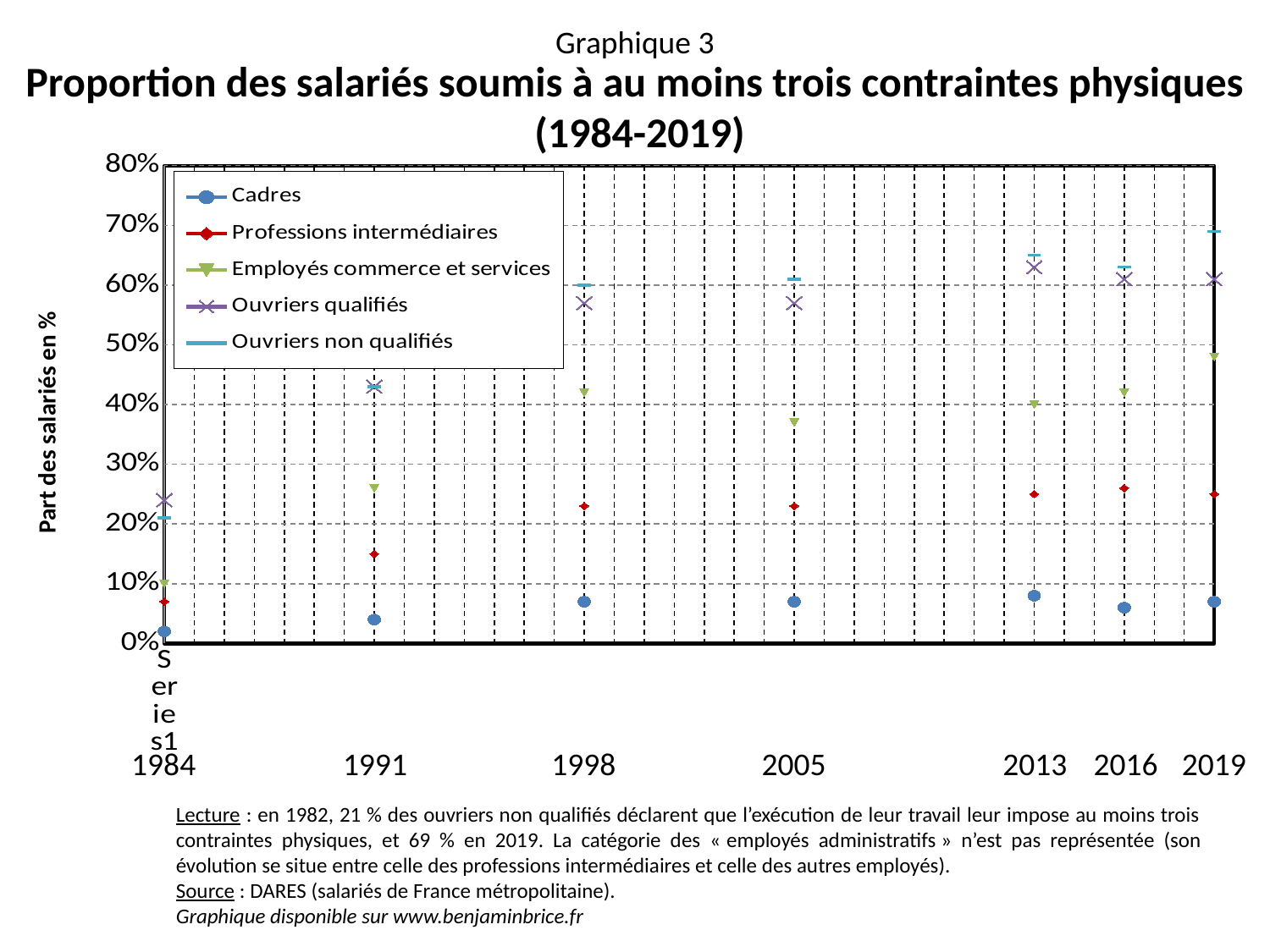
What is the title of the y axis? Part des salariés en % Is the value for Ouvriers qualifiés in 1984 greater or less than 20%? greater Is the value for Employés commerce et services in 2019 greater or less than 50%? less How many series does the legend list? 5 In 2019, which is larger: Employés commerce et services or Professions intermédiaires? Employés commerce et services Is the value for Cadres in 2019 greater or less than 10%? less According to the note below the chart, what is the value for Ouvriers non qualifiés in 2019? 69 % How many years are shown on the x axis? 7 Which series has the highest value in 2019? Ouvriers non qualifiés Which series has the lowest value in 2019? Cadres Does the value for Ouvriers non qualifiés rise or fall between 1984 and 2019? rise